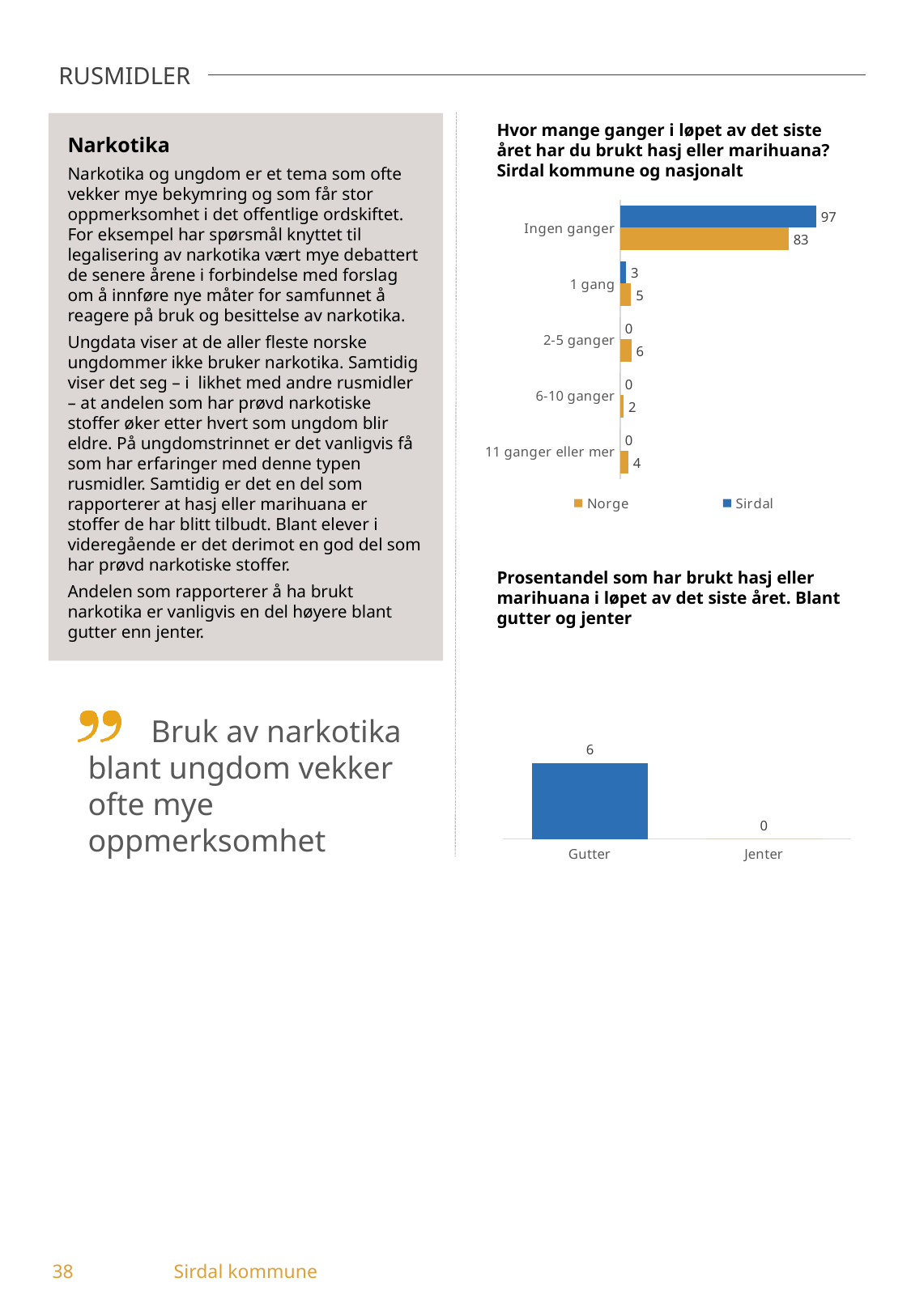
In the chart 'Hvor mange ganger i løpet av det siste året har du brukt hasj eller marihuana?', what is the value for Norge for '2-5 ganger'? 6 What kind of chart is 'Hvor mange ganger i løpet av det siste året har du brukt hasj eller marihuana?'? Bar chart In the chart 'Hvor mange ganger i løpet av det siste året har du brukt hasj eller marihuana?', which colour represents Norge? Orange In the chart 'Hvor mange ganger i løpet av det siste året har du brukt hasj eller marihuana?', which series has the larger value for '1 gang', Norge or Sirdal? Norge In the chart 'Hvor mange ganger i løpet av det siste året har du brukt hasj eller marihuana?', how many categories are shown? 5 In the chart 'Hvor mange ganger i løpet av det siste året har du brukt hasj eller marihuana?', what is the value for Sirdal for 'Ingen ganger'? 97 In the chart 'Prosentandel som har brukt hasj eller marihuana i løpet av det siste året', what is the value for Gutter? 6 In the chart 'Hvor mange ganger i løpet av det siste året har du brukt hasj eller marihuana?', how many series does the legend list? 2 In the chart 'Hvor mange ganger i løpet av det siste året har du brukt hasj eller marihuana?', what is the value for Sirdal for '1 gang'? 3 In the chart 'Hvor mange ganger i løpet av det siste året har du brukt hasj eller marihuana?', what is the value for Norge for 'Ingen ganger'? 83 In the chart 'Hvor mange ganger i løpet av det siste året har du brukt hasj eller marihuana?', what is the difference between the Sirdal and Norge values for 'Ingen ganger'? 14 In the chart 'Prosentandel som har brukt hasj eller marihuana i løpet av det siste året', which category has the lowest value? Jenter